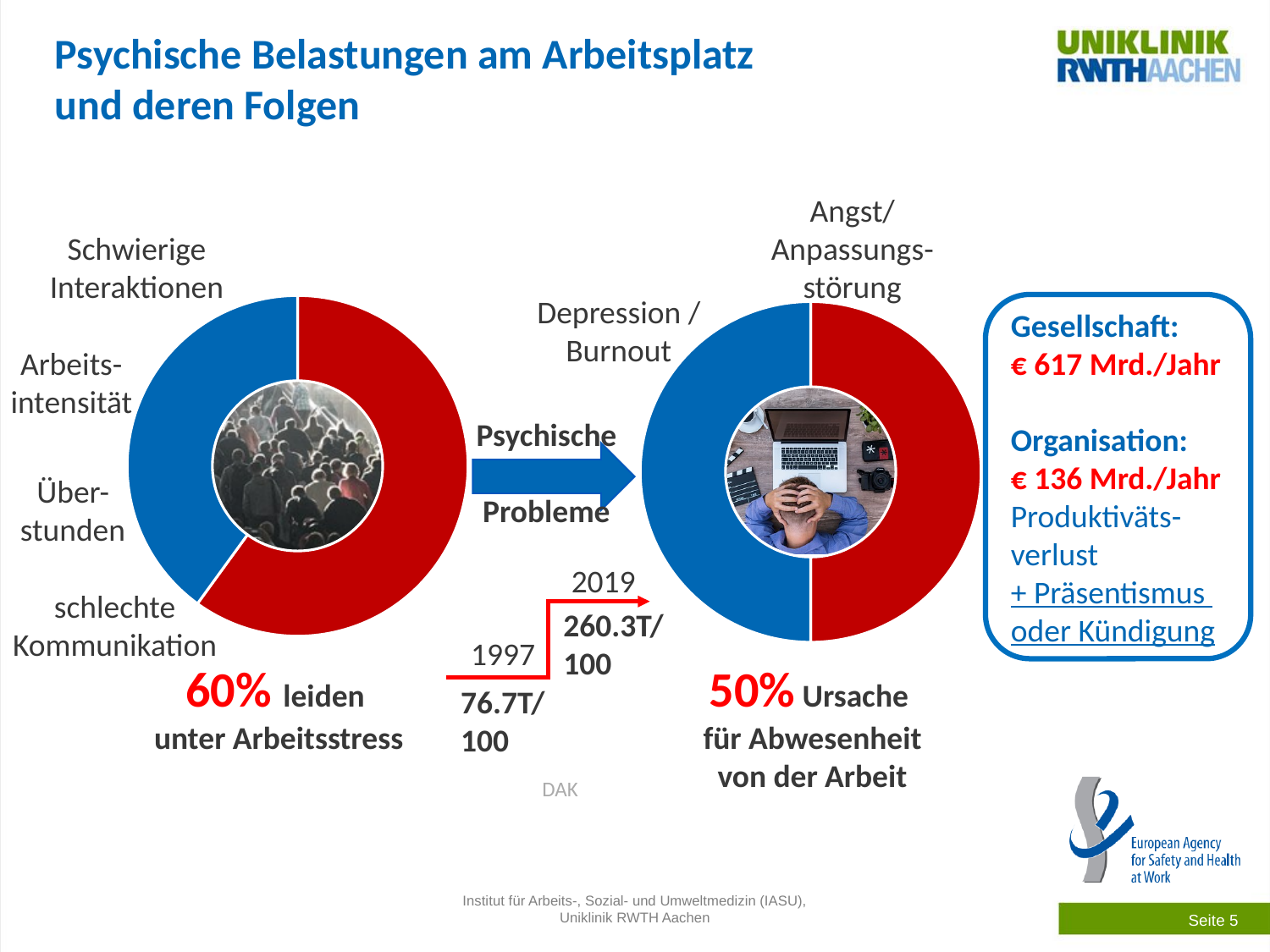
What kind of chart is the left chart on the slide (the one labelled '60% leiden unter Arbeitsstress')? doughnut chart In the right chart, what share of the doughnut does the red slice represent, according to the text below it? 50% What percentage of people is stated to suffer from work stress ('leiden unter Arbeitsstress') next to the left chart? 60% In the right chart, how many slices does the doughnut have? 2 In the left chart, how many slices does the doughnut have? 2 In the left chart, which slice is larger, the red one or the blue one? red What is the title of the slide containing the two doughnut charts? Psychische Belastungen am Arbeitsplatz und deren Folgen In the left chart, what share of the doughnut does the red slice represent, according to the text below it? 60% What kind of chart is the right chart on the slide (the one labelled '50% Ursache für Abwesenheit von der Arbeit')? doughnut chart In the right chart, are the red and blue slices equal in size? yes In the left chart, is the red slice's share greater or less than 50%? greater What two colours are used for the slices in the left chart? blue and red